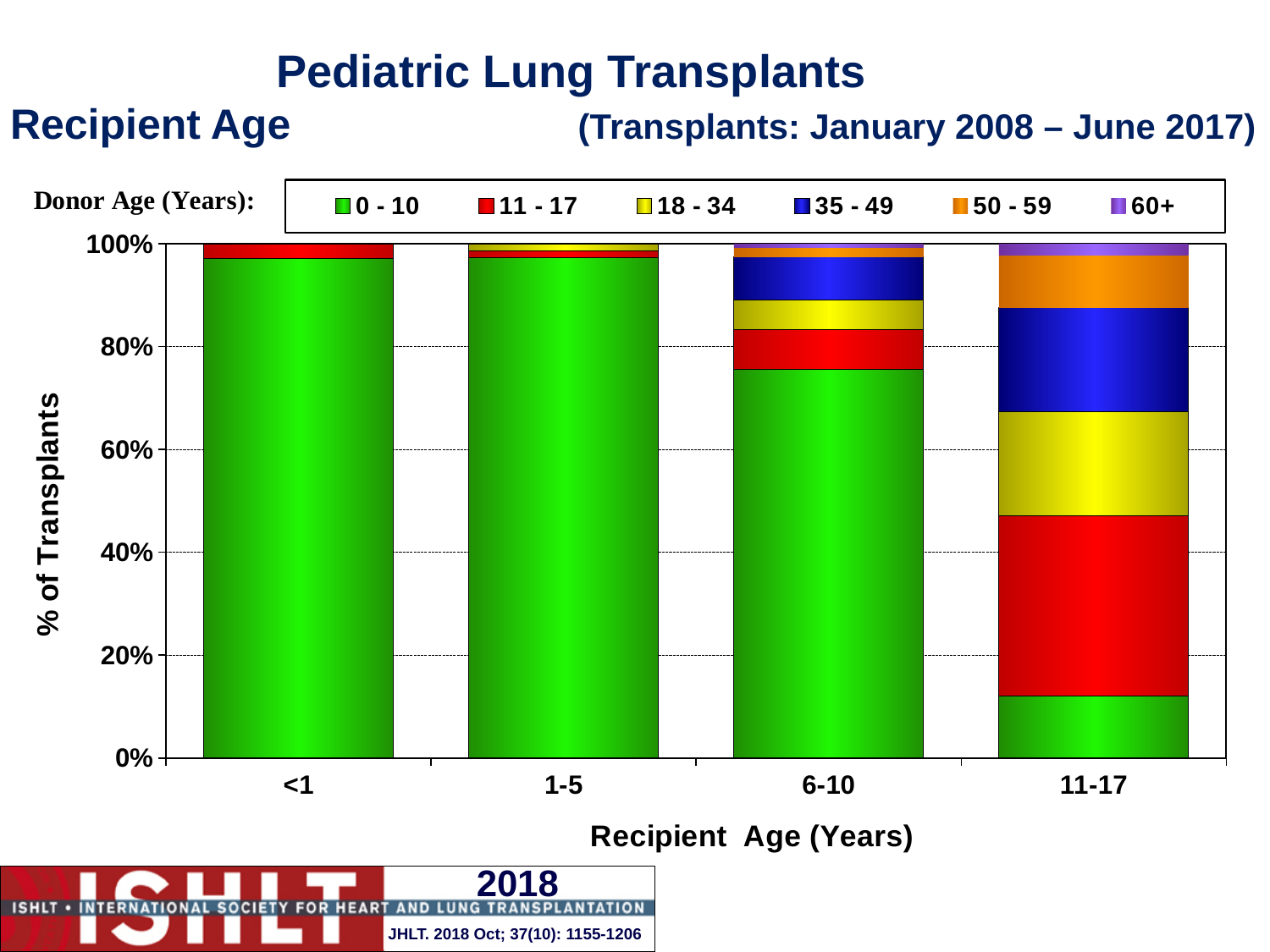
What is the label of the y axis? % of Transplants How many recipient age groups are shown on the x axis? 4 Is the share of 11 - 17 year old donors for recipients aged 11-17 greater or less than 20%? greater Is the share of 0 - 10 year old donors for recipients aged 6-10 greater or less than 60%? greater Is the share of 0 - 10 year old donors for recipients aged 11-17 greater or less than 20%? less Which recipient age group has the largest share of 11 - 17 year old donors? 11-17 What kind of chart is shown on the slide? Stacked bar chart How many donor age series does the legend list? 6 Which recipient age group has the smallest share of 0 - 10 year old donors? 11-17 Which has a larger share of 0 - 10 year old donors: recipients aged <1 or recipients aged 11-17? <1 Does the share of 0 - 10 year old donors rise or fall as recipient age increases along the x axis? fall